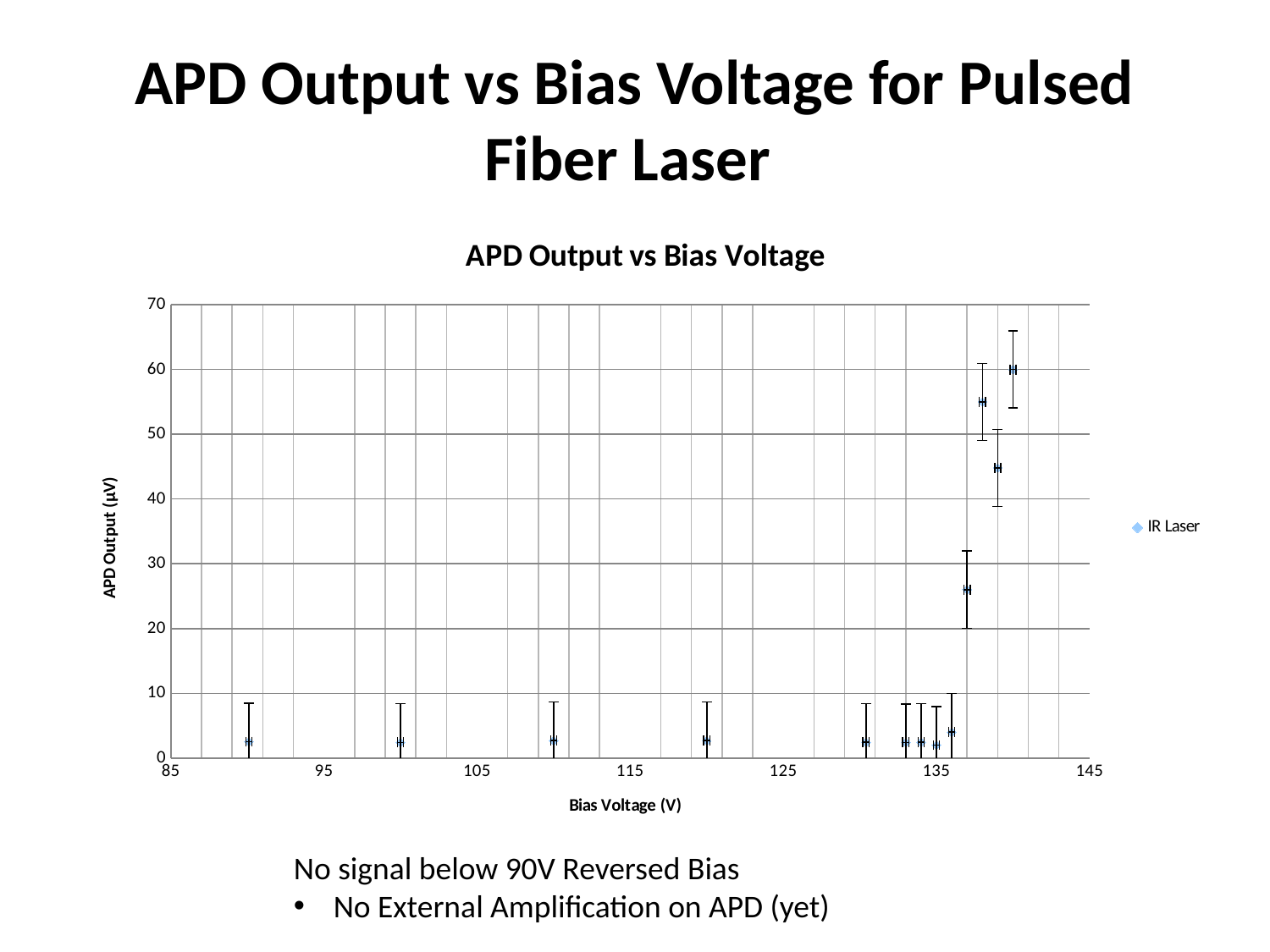
At which bias voltage is the APD output highest? 140 V How many series does the legend list? 1 Which has the higher APD output: the point at 138 V or the point at 139 V? 138 V Is the APD output at a bias voltage of 90 V greater or less than 10? less Is the APD output at a bias voltage of 139 V greater or less than 40? greater What is the title of the x axis? Bias Voltage (V) Is the APD output at a bias voltage of 120 V greater or less than 10? less Overall, does the APD output rise or fall as the bias voltage increases? Rises What kind of chart is shown on the slide? Scatter chart What is the name of the series shown in the legend? IR Laser